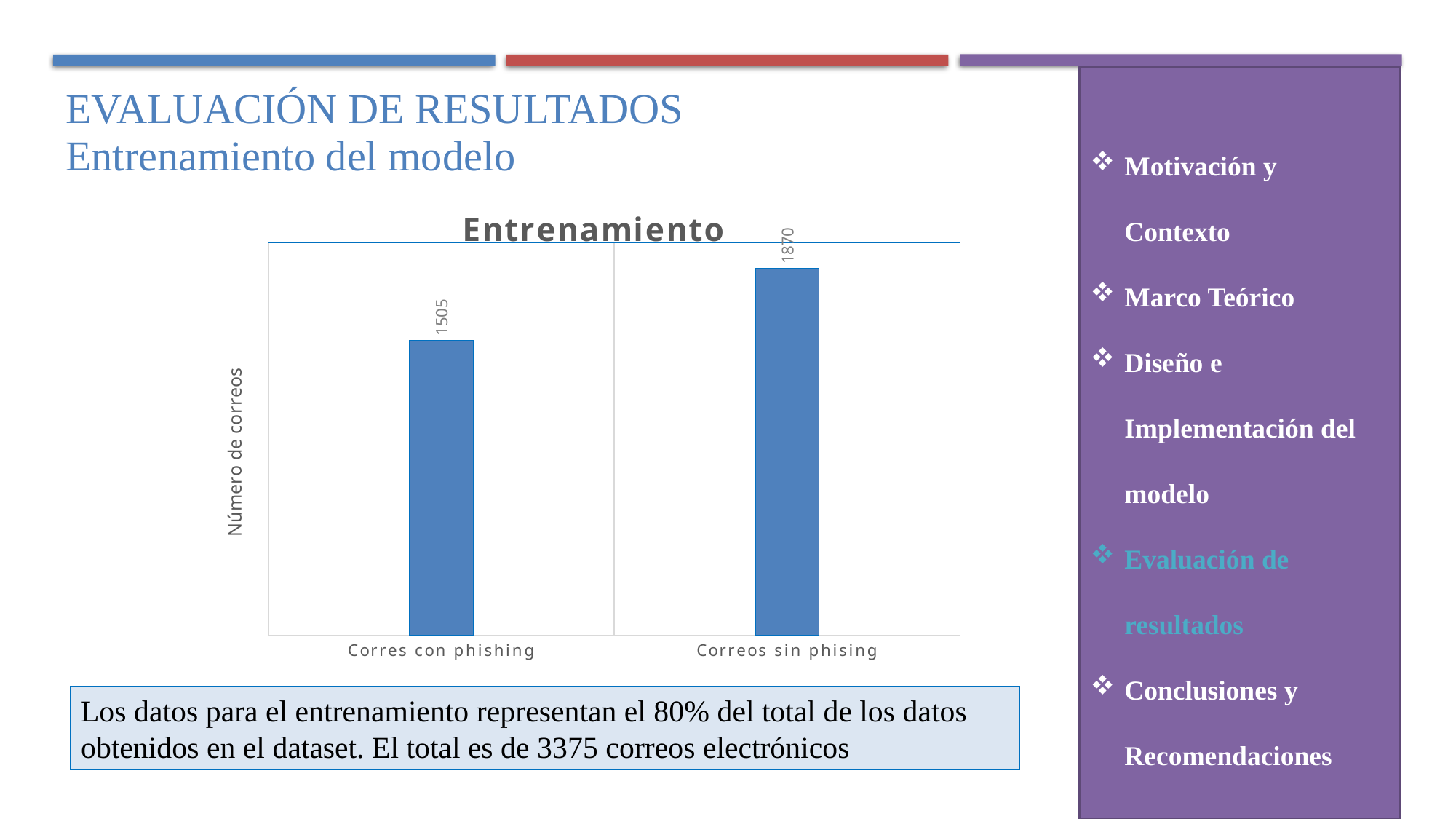
What is the total of the two bars in the chart? 3375 What is the label of the vertical axis? Número de correos What is the title of the chart? Entrenamiento Which category has the lowest value? Corres con phishing What is the value for Correos sin phising? 1870 How many categories are shown in the chart? 2 What is the difference between the values for Correos sin phising and Corres con phishing? 365 Which is larger, the value for Corres con phishing or the value for Correos sin phising? Correos sin phising What kind of chart is shown on the slide? Bar chart Which category has the highest value? Correos sin phising What is the value for Corres con phishing? 1505